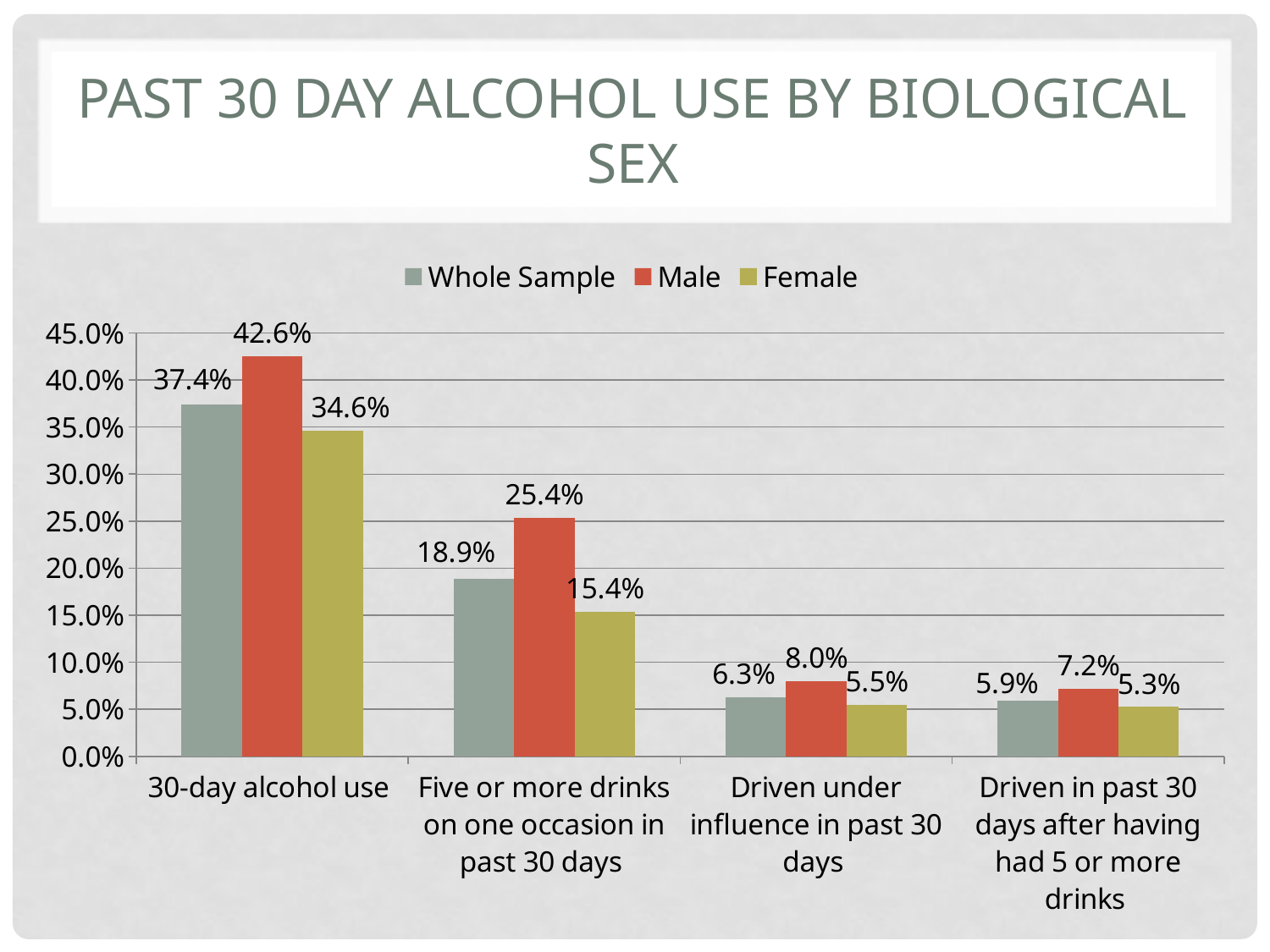
What kind of chart is shown on the slide? Bar chart What is the Whole Sample value for Driven under influence in past 30 days? 6.3% What is the difference between the Male and Female values for 30-day alcohol use? 8.0% Is the Whole Sample value for 30-day alcohol use greater or less than 35.0%? greater How many categories are shown on the x axis? 4 Which category has the lowest Female value? Driven in past 30 days after having had 5 or more drinks Which is larger for Five or more drinks on one occasion in past 30 days: the Male value or the Whole Sample value? Male How many series does the legend list? 3 What is the Female value for Five or more drinks on one occasion in past 30 days? 15.4% What is the title of the slide? Past 30 Day Alcohol Use by Biological Sex What is the Male value for 30-day alcohol use? 42.6% Which category has the highest Male value? 30-day alcohol use